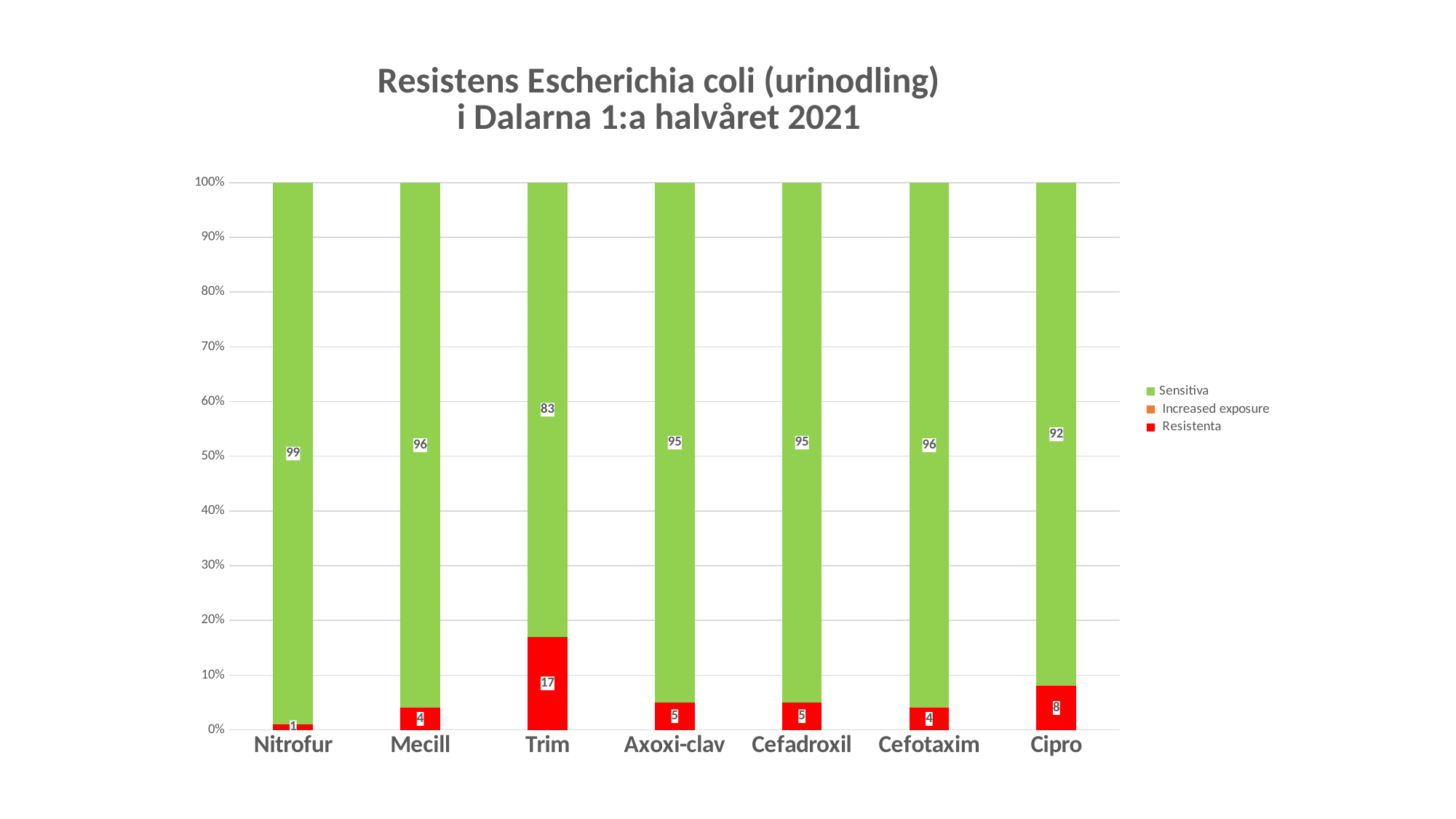
What is the difference between the Resistenta values for Trim and Cipro? 9 How many series does the legend list? 3 What is the Sensitiva value for Trim? 83 Which category has the lowest Resistenta value? Nitrofur How many categories are shown on the x axis? 7 What is the Resistenta value for Cipro? 8 What kind of chart is shown on the slide? Stacked bar chart Which category has the highest Resistenta value? Trim What is the Sensitiva value for Nitrofur? 99 What is the title of the chart? Resistens Escherichia coli (urinodling) i Dalarna 1:a halvåret 2021 Which colour represents the Resistenta series? Red Which has a larger Sensitiva value, Mecill or Cipro? Mecill